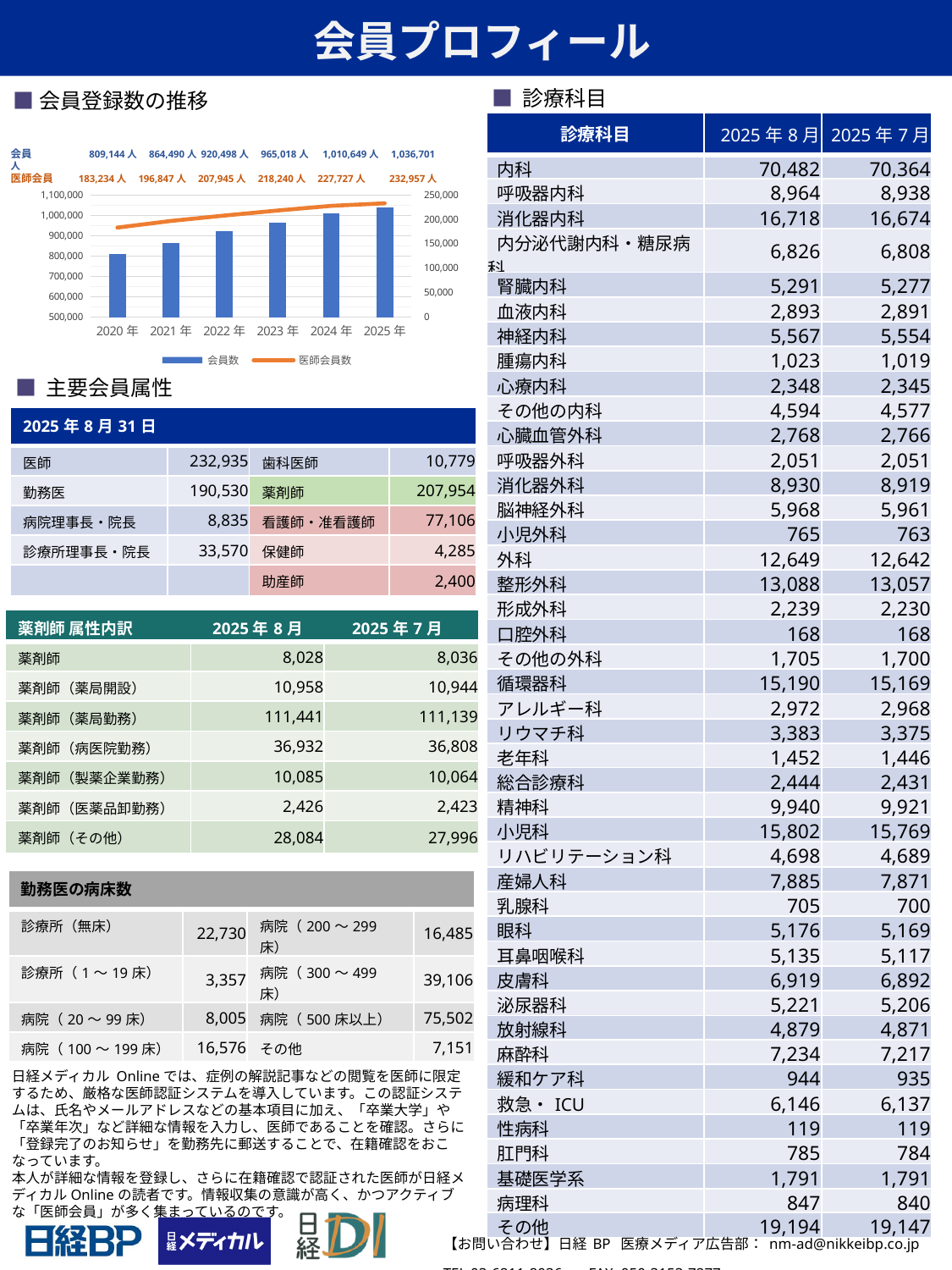
In the 会員登録数の推移 chart, what is the 会員 value for 2020年? 809,144人 In the 会員登録数の推移 chart, is the 会員 value for 2024年 larger or smaller than the value for 2022年? larger In the 会員登録数の推移 chart, how many series does the legend list? 2 In the 会員登録数の推移 chart, what is the 医師会員 value for 2022年? 207,945人 In the 会員登録数の推移 chart, how many years are shown on the x axis? 6 In the 会員登録数の推移 chart, which year has the highest 会員 value? 2025年 In the 会員登録数の推移 chart, do the 会員 values rise or fall from 2020年 to 2025年? rise In the 会員登録数の推移 chart, which year has the lowest 医師会員 value? 2020年 In the 会員登録数の推移 chart, what kind of chart is used to show 会員数? bar chart In the 会員登録数の推移 chart, what is the 会員 value for 2023年? 965,018人 In the 会員登録数の推移 chart, what is the 医師会員 value for 2025年? 232,957人 In the 会員登録数の推移 chart, what is the difference between the 医師会員 values for 2021年 and 2020年? 13,613人